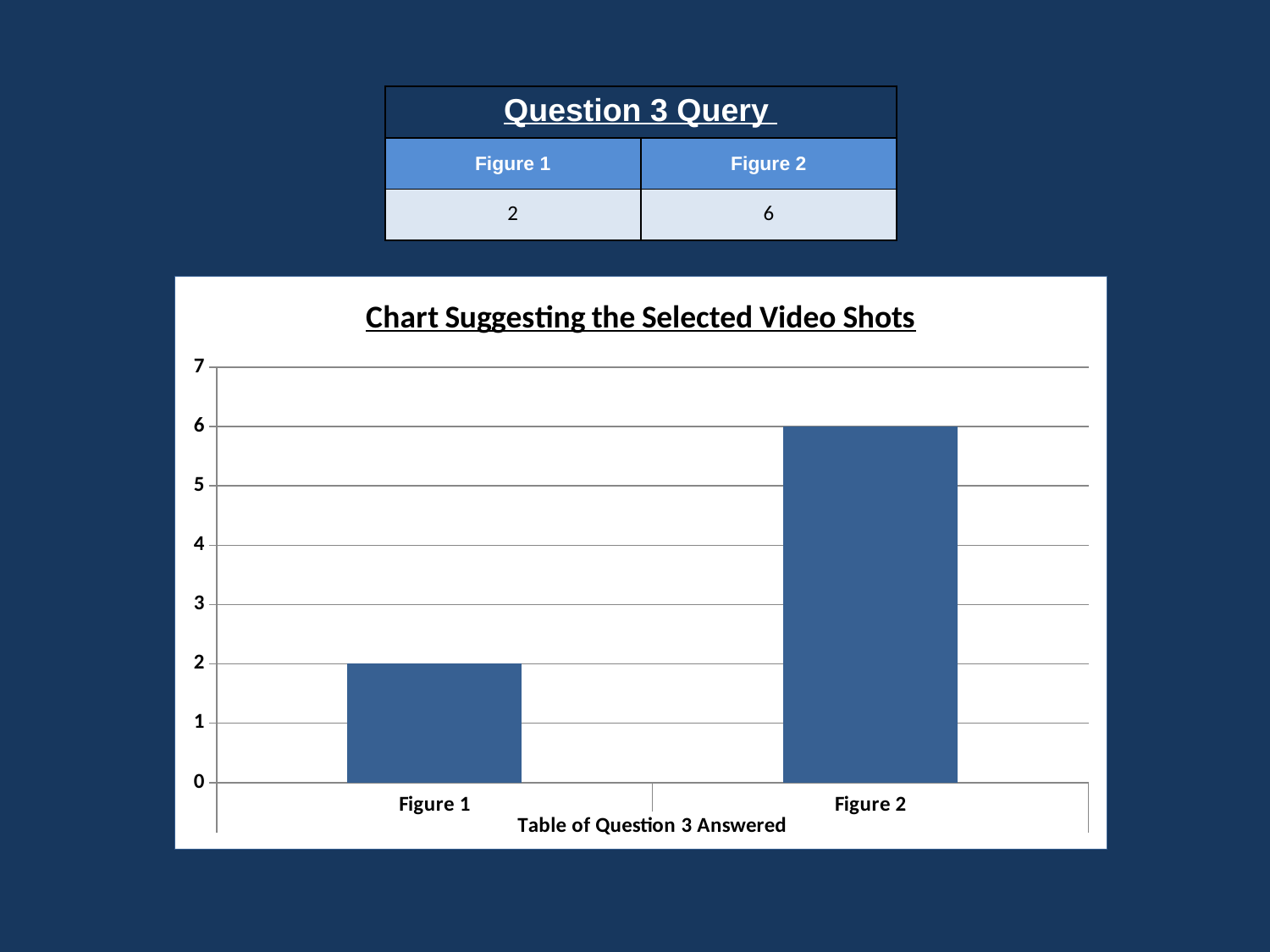
Is the value for Figure 2 greater or less than 5? greater Which category has the highest value in the chart? Figure 2 What is the value for Figure 2 in the chart? 6 What is the title of the chart? Chart Suggesting the Selected Video Shots What is the difference between the values for Figure 2 and Figure 1? 4 Which category has the lowest value in the chart? Figure 1 What is the value for Figure 1 in the chart? 2 How many categories are shown in the chart? 2 What is the label on the horizontal axis of the chart? Table of Question 3 Answered What kind of chart is shown on the slide? bar chart Which is larger, the value for Figure 1 or the value for Figure 2? Figure 2 Is the value for Figure 1 greater or less than 3? less